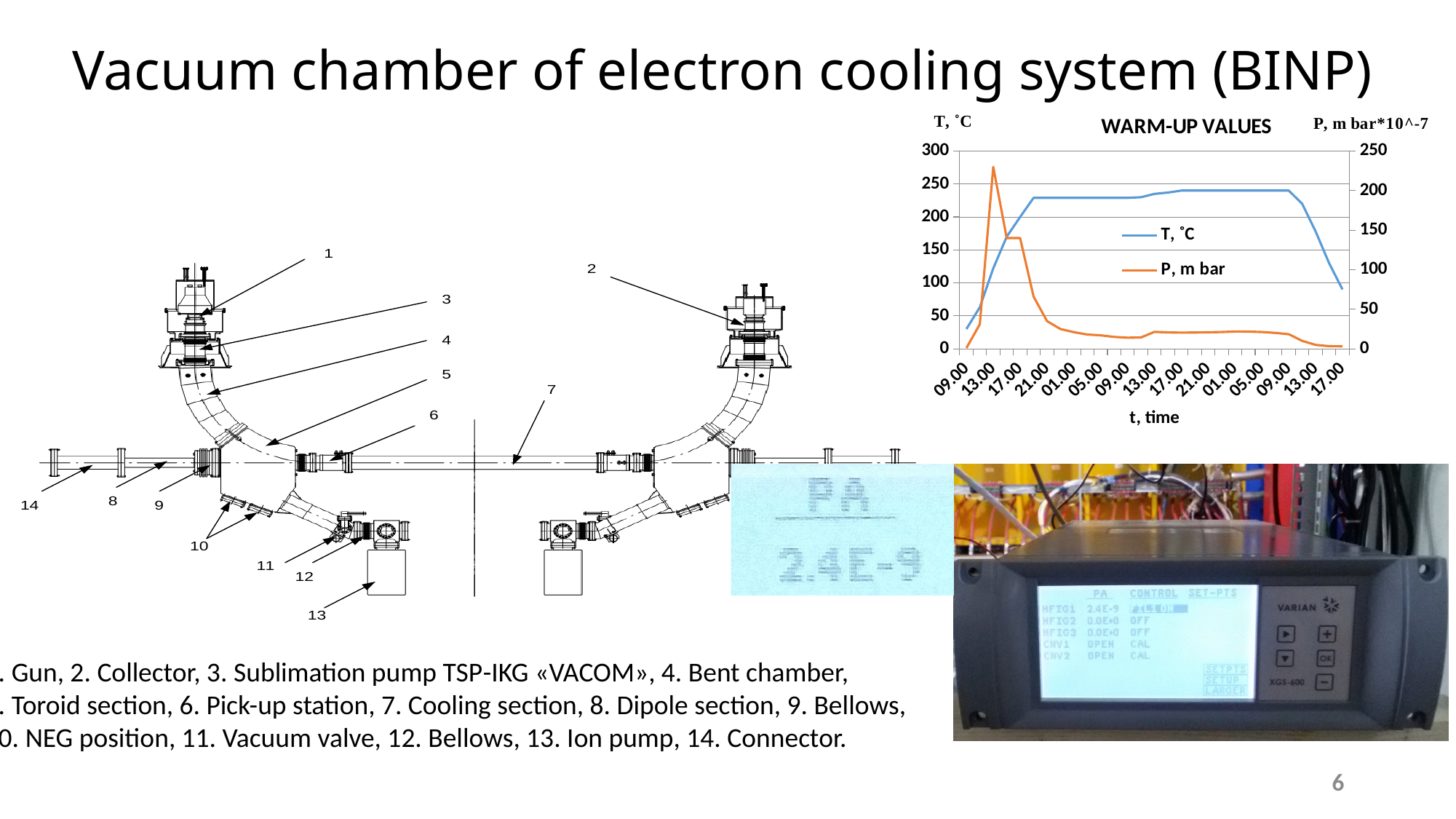
How many time labels are shown along the x axis of the WARM-UP VALUES chart? 15 In the WARM-UP VALUES chart, is the T, ˚C value at the first 21.00 label greater or less than 200? greater In the WARM-UP VALUES chart, does the T, ˚C series rise or fall between the first 09.00 label and the first 21.00 label? rise What kind of chart is the WARM-UP VALUES chart? line chart In the WARM-UP VALUES chart, does the P, m bar series rise or fall between the first 17.00 label and the first 01.00 label? fall In the WARM-UP VALUES chart, is the T, ˚C value at the first 09.00 label greater or less than 50? less Which series in the WARM-UP VALUES chart is drawn in orange? P, m bar What is the title of the chart on the slide? WARM-UP VALUES In the WARM-UP VALUES chart, is the peak value of the P, m bar series greater or less than 200 on the right axis? greater In the WARM-UP VALUES chart, does the T, ˚C series rise or fall between the last 09.00 label and the last 17.00 label? fall How many series does the legend of the WARM-UP VALUES chart list? 2